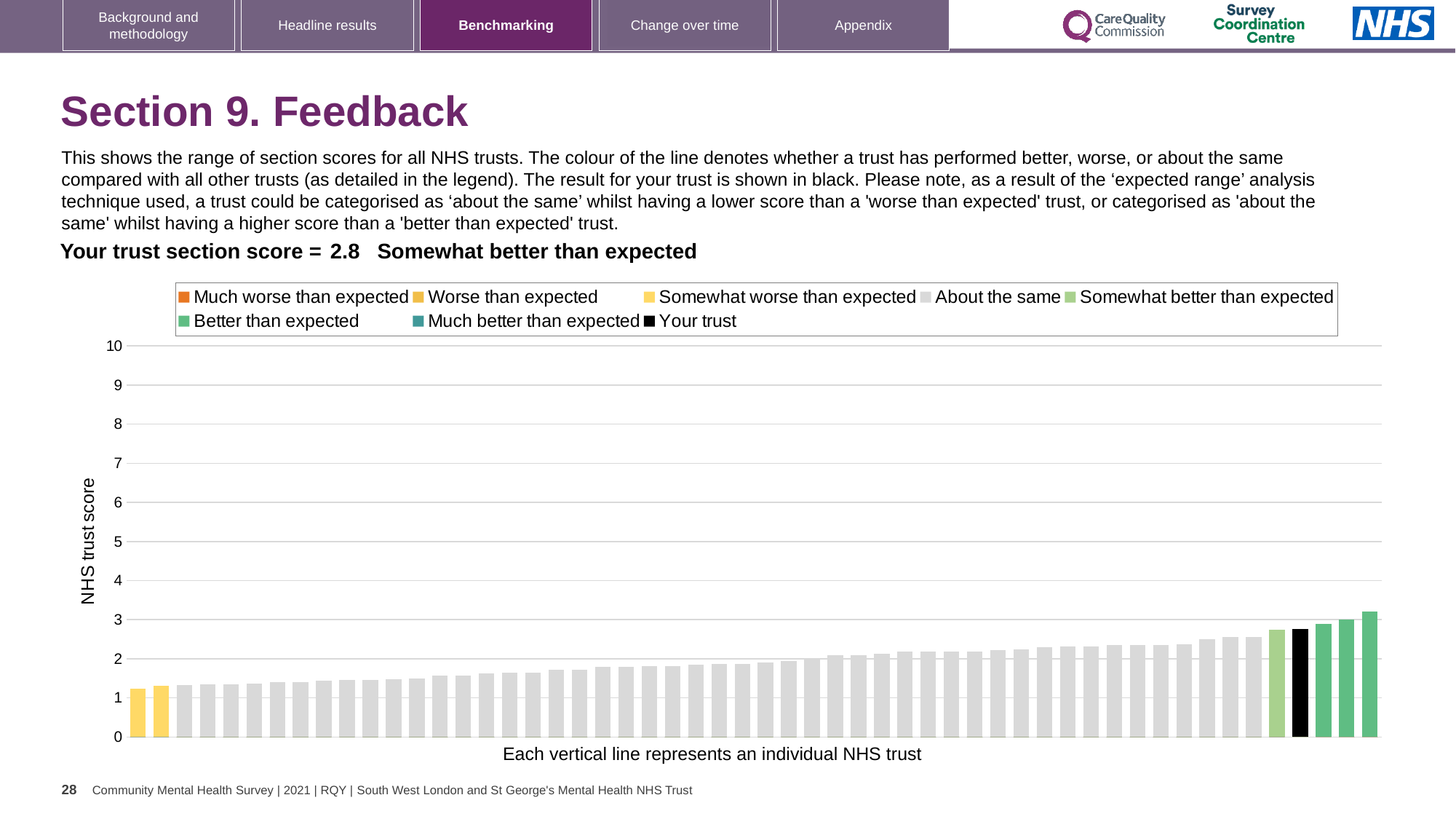
Is the value of the leftmost bar greater or less than 2? less What is the section score for your trust shown on the slide? 2.8 How many bars are coloured as 'Somewhat worse than expected' (yellow)? 2 How many entries does the chart legend list? 8 Which benchmarking category is your trust's section score placed in? Somewhat better than expected Is the value of the tallest bar greater or less than 3? greater Do the bar values rise or fall from left to right along the x axis? rise Is the value for your trust (the black bar) greater or less than 2? greater How many bars are coloured as 'Better than expected' (green)? 3 What is the label on the vertical axis of the chart? NHS trust score What kind of chart is shown on the slide? bar chart